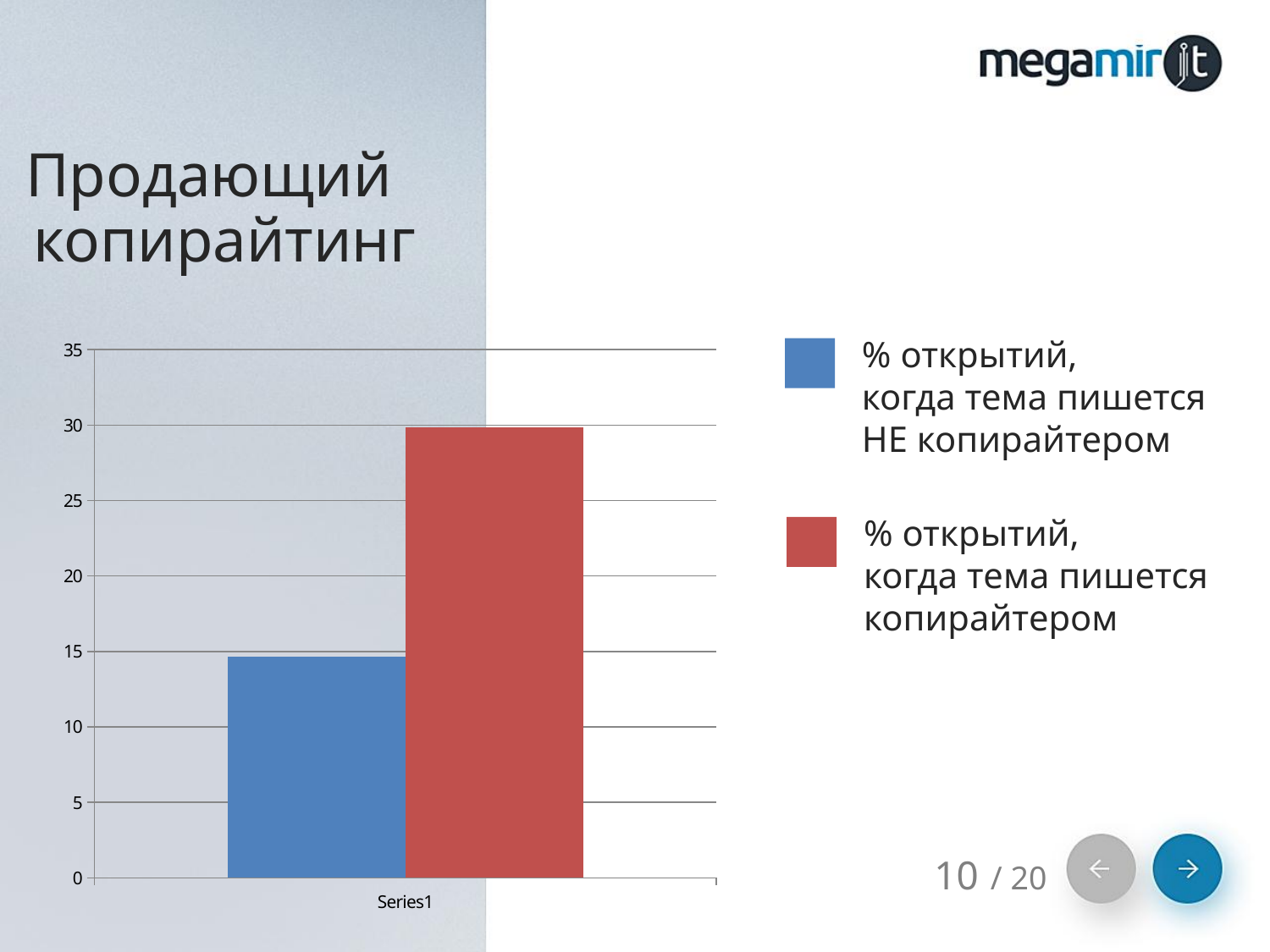
Which series has the highest value in the chart? % открытий, когда тема пишется копирайтером How many bars are plotted in the chart? 2 What is the maximum value shown on the vertical axis of the chart? 35 Is the value of the blue bar (% открытий, когда тема пишется НЕ копирайтером) greater or less than 10? greater Is the value of the red bar (% открытий, когда тема пишется копирайтером) greater or less than 35? less What kind of chart is shown on the slide? bar chart What category label is shown under the bars on the horizontal axis? Series1 Is the value of the red bar (% открытий, когда тема пишется копирайтером) greater or less than 25? greater Which series has the lowest value in the chart? % открытий, когда тема пишется НЕ копирайтером Which bar is taller: the blue bar (% открытий, когда тема пишется НЕ копирайтером) or the red bar (% открытий, когда тема пишется копирайтером)? the red bar